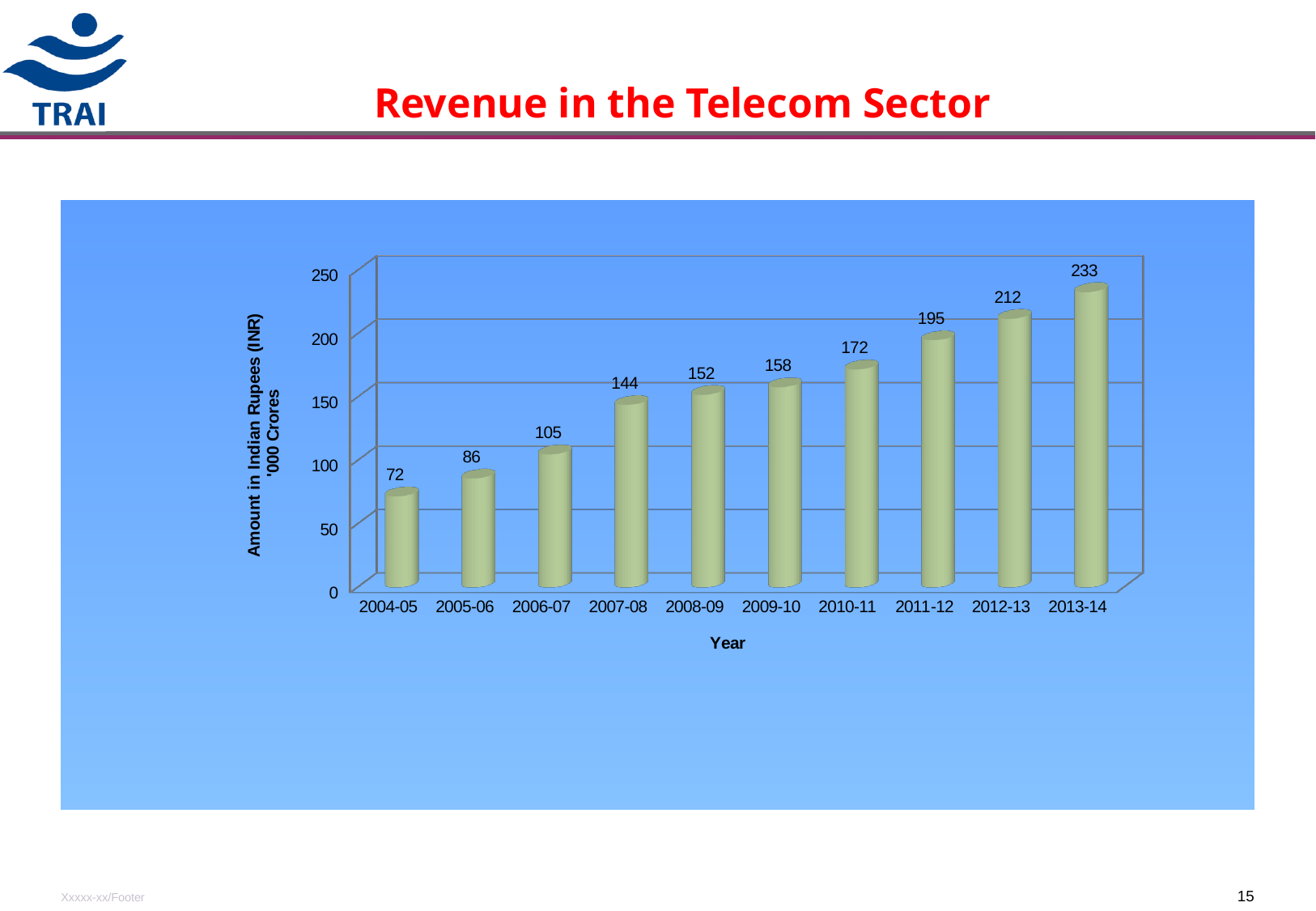
What is the difference between the revenue in 2011-12 and 2010-11? 23 Which year has a larger revenue, 2006-07 or 2007-08? 2007-08 Which year has the lowest revenue? 2004-05 What kind of chart is shown on the slide? bar chart What is the revenue value shown for 2012-13? 212 Do the revenue values rise or fall from 2004-05 to 2013-14? rise What is the revenue value shown for 2004-05? 72 Which year has the highest revenue? 2013-14 What is the revenue value shown for 2009-10? 158 What is the difference between the revenue in 2013-14 and 2004-05? 161 Is the value for 2008-09 greater or less than 100? greater How many years are shown on the x axis? 10